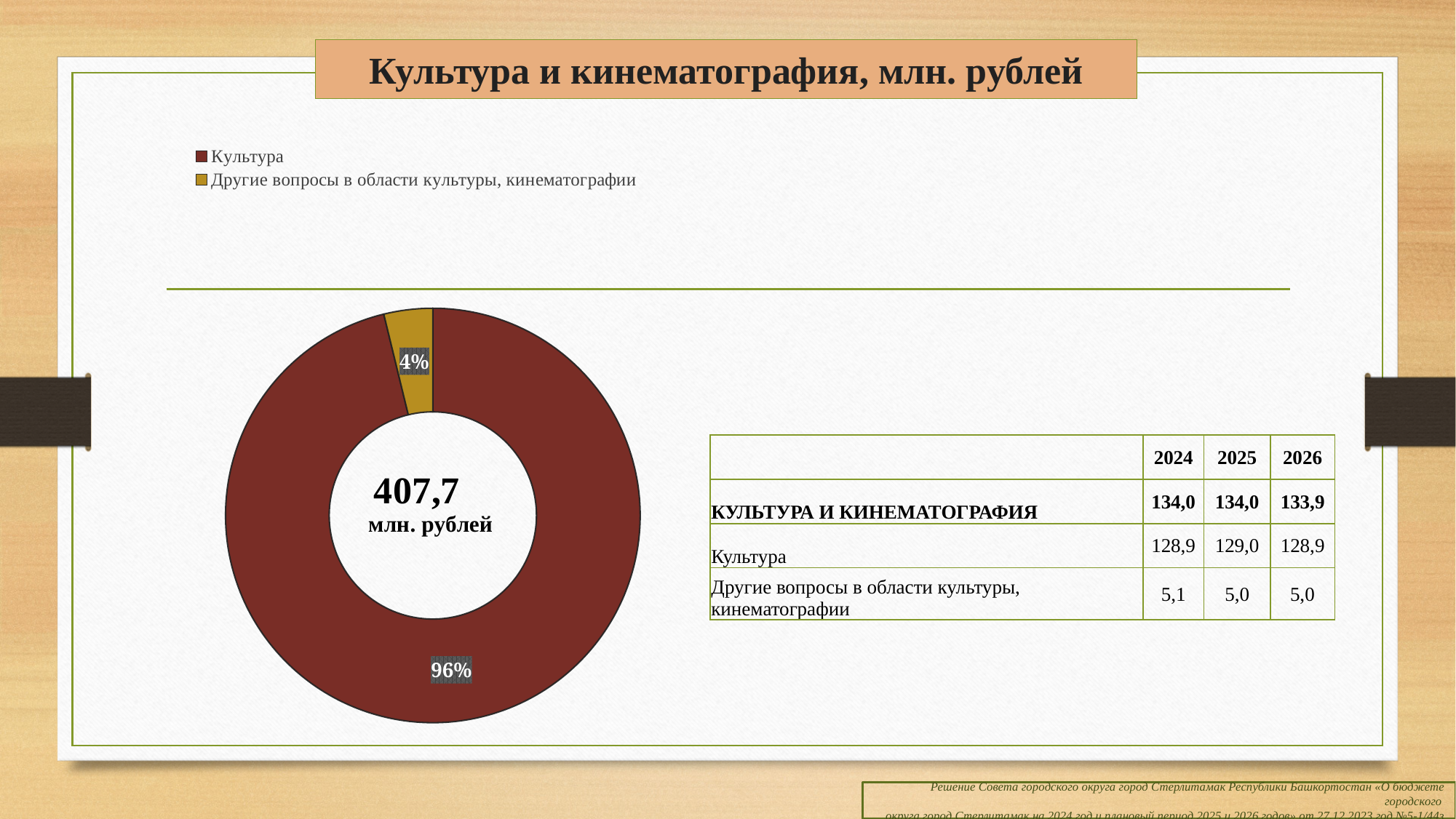
What colour is the Культура slice in the doughnut chart? Dark red Which slice of the doughnut chart is the smallest? Другие вопросы в области культуры, кинематографии How many slices does the doughnut chart have? 2 What share of the doughnut chart does Культура take? 96% What is the difference in percentage points between the Культура slice and the Другие вопросы в области культуры, кинематографии slice? 92 percentage points What total value is printed in the centre of the doughnut chart? 407,7 млн. рублей What share of the doughnut chart does Другие вопросы в области культуры, кинематографии take? 4% Which is larger in the doughnut chart: Культура or Другие вопросы в области культуры, кинематографии? Культура How many entries does the chart legend list? 2 What kind of chart is shown on the slide? Doughnut (pie) chart What is the title of the chart on the slide? Культура и кинематография, млн. рублей Which slice of the doughnut chart is the largest? Культура